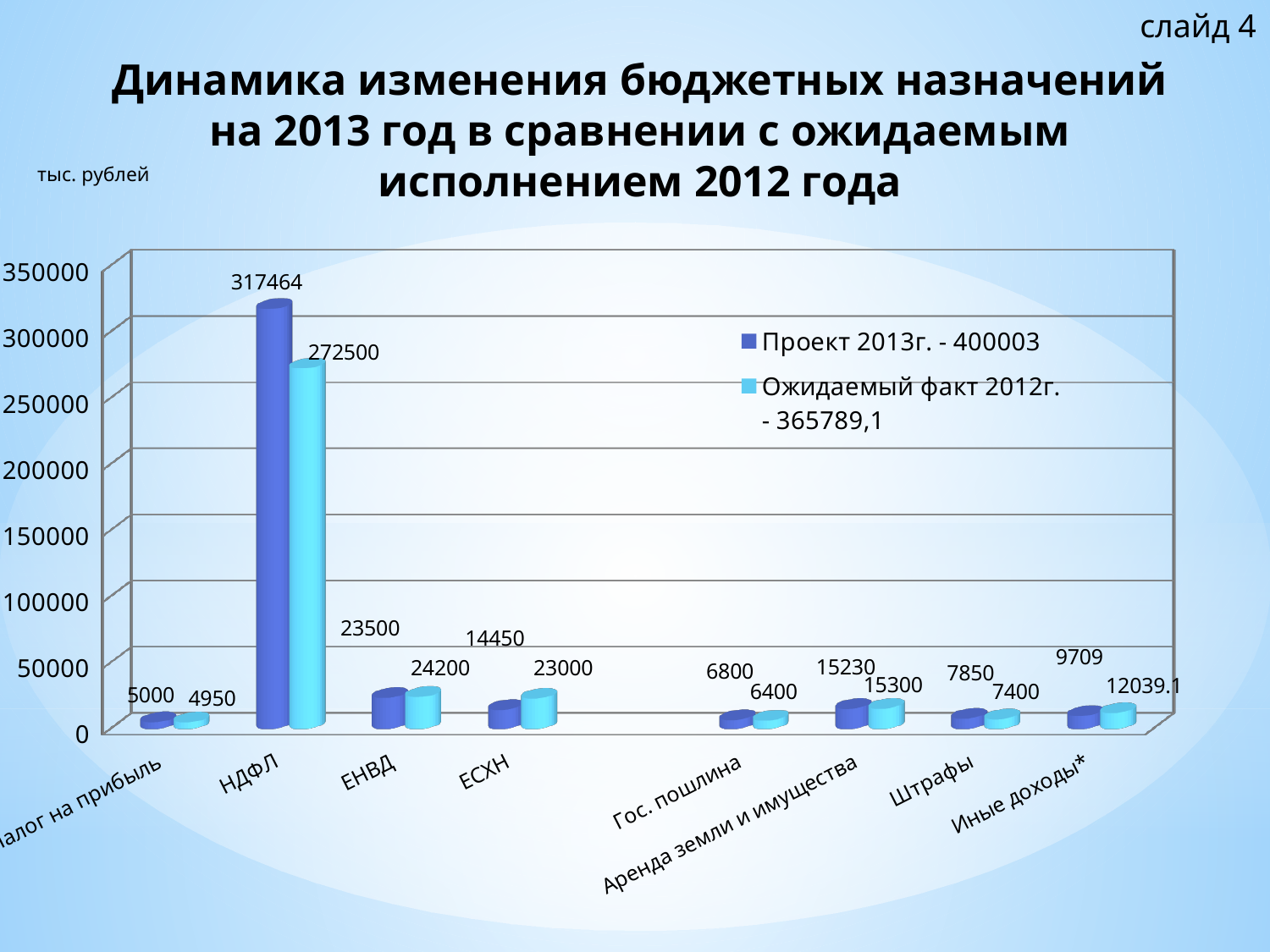
What unit is indicated above the chart? тыс. рублей What kind of chart is shown on the slide? bar chart Is the Проект 2013г. value for НДФЛ greater or less than 300000? greater What is the value for Иные доходы* in the Ожидаемый факт 2012г. series? 12039.1 For ЕСХН, which is larger: the Проект 2013г. value or the Ожидаемый факт 2012г. value? Ожидаемый факт 2012г. What is the value for ЕСХН in the Ожидаемый факт 2012г. series? 23000 What is the value for НДФЛ in the Ожидаемый факт 2012г. series? 272500 What is the value for НДФЛ in the Проект 2013г. series? 317464 How many series does the legend list? 2 Which category has the lowest value in the Ожидаемый факт 2012г. series? Налог на прибыль What is the difference between the Проект 2013г. and Ожидаемый факт 2012г. values for НДФЛ? 44964 Which category has the highest value in the Проект 2013г. series? НДФЛ